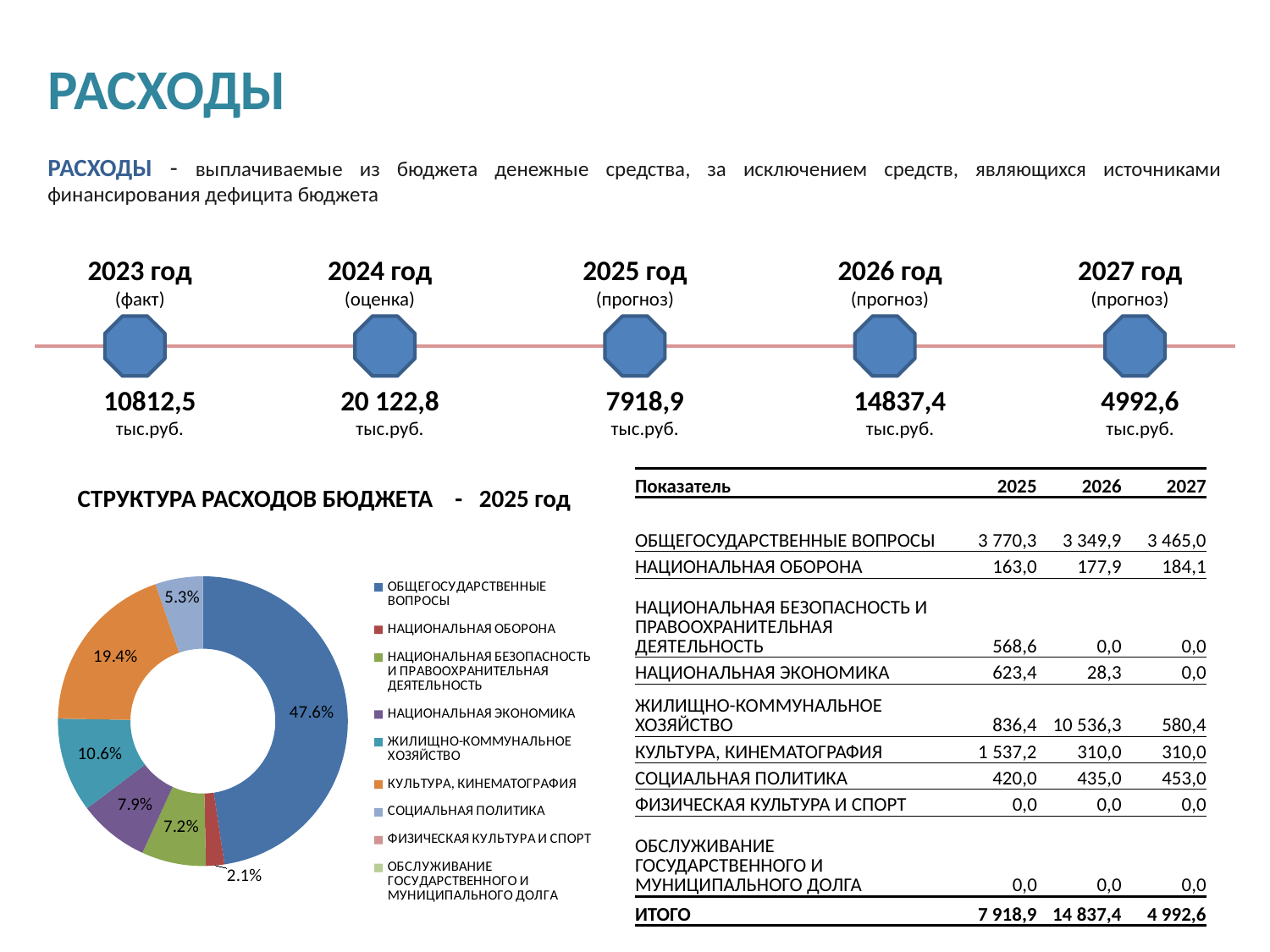
In the doughnut chart, what share is shown for ЖИЛИЩНО-КОММУНАЛЬНОЕ ХОЗЯЙСТВО? 10.6% How many entries does the legend of the doughnut chart list? 9 Which of the labelled slices in the doughnut chart is the smallest? НАЦИОНАЛЬНАЯ ОБОРОНА (2.1%) What kind of chart is shown under the title 'СТРУКТУРА РАСХОДОВ БЮДЖЕТА - 2025 год'? Doughnut (pie) chart In the doughnut chart, what is the difference in percentage points between the ОБЩЕГОСУДАРСТВЕННЫЕ ВОПРОСЫ slice and the КУЛЬТУРА, КИНЕМАТОГРАФИЯ slice? 28.2 percentage points In the doughnut chart, which slice is larger: НАЦИОНАЛЬНАЯ ЭКОНОМИКА or НАЦИОНАЛЬНАЯ БЕЗОПАСНОСТЬ И ПРАВООХРАНИТЕЛЬНАЯ ДЕЯТЕЛЬНОСТЬ? НАЦИОНАЛЬНАЯ ЭКОНОМИКА In the doughnut chart, what share is shown for ОБЩЕГОСУДАРСТВЕННЫЕ ВОПРОСЫ? 47.6% In the doughnut chart, what share is shown for СОЦИАЛЬНАЯ ПОЛИТИКА? 5.3% What is the title of the doughnut chart? СТРУКТУРА РАСХОДОВ БЮДЖЕТА - 2025 год In the doughnut chart, what share is shown for НАЦИОНАЛЬНАЯ ОБОРОНА? 2.1% Which category has the largest slice in the doughnut chart? ОБЩЕГОСУДАРСТВЕННЫЕ ВОПРОСЫ In the doughnut chart, what share is shown for КУЛЬТУРА, КИНЕМАТОГРАФИЯ? 19.4%